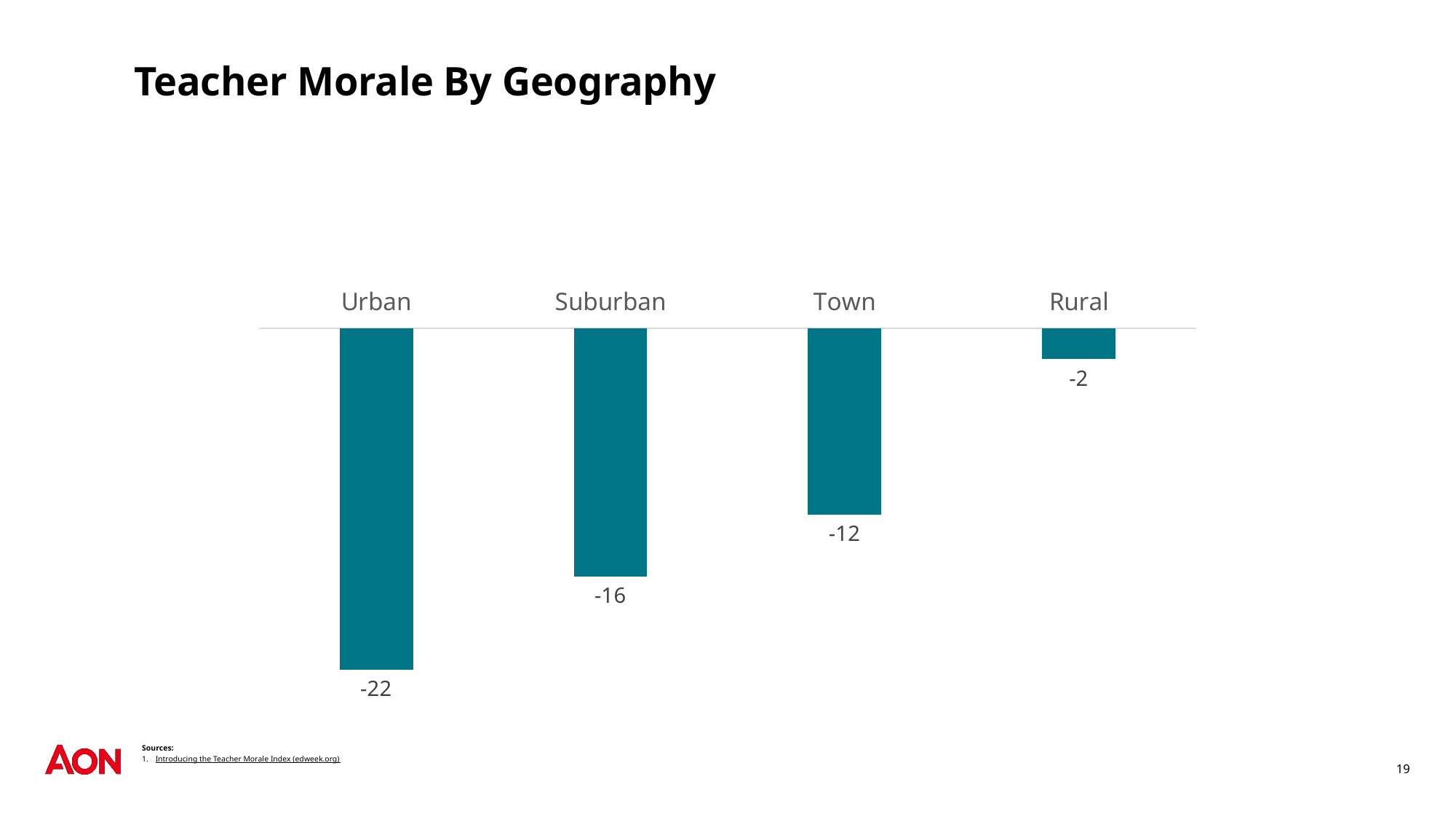
Which geography has the lowest teacher morale value? Urban What is the difference between the Urban and Rural values? 20 Which geography has the highest teacher morale value? Rural Do the values rise or fall moving from Urban to Rural along the x axis? Rise What is the teacher morale value for Suburban? -16 What is the teacher morale value for Rural? -2 How many geography categories are shown in the chart? 4 What is the teacher morale value for Town? -12 Which is larger, the value for Town or the value for Suburban? Town What is the teacher morale value for Urban? -22 What kind of chart is shown on the slide? Bar chart What is the difference between the Suburban and Town values? 4